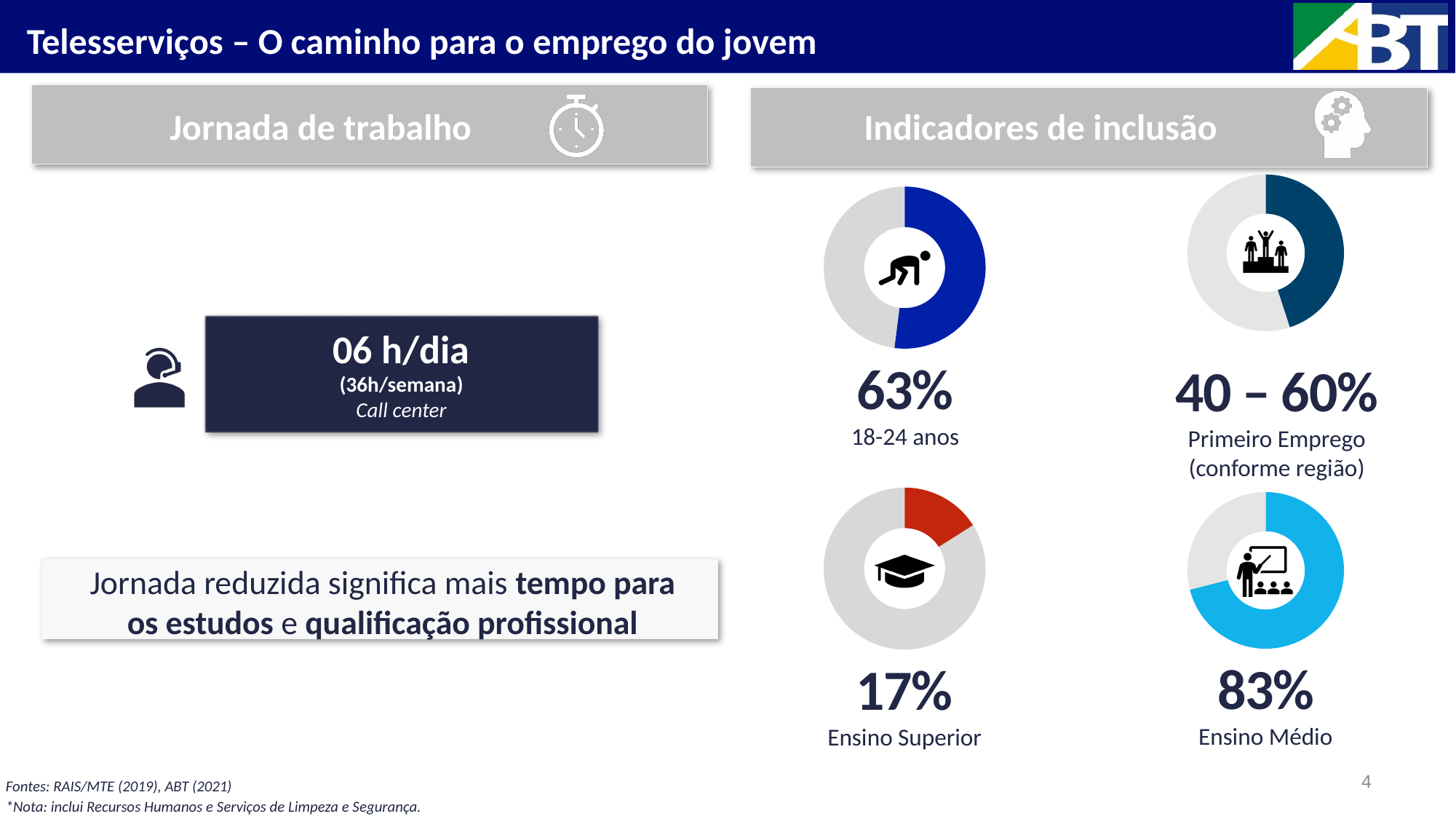
In the "Ensino Superior" donut chart, what percentage is shown? 17% What range is shown for the "Primeiro Emprego (conforme região)" donut chart? 40 – 60% What is the difference between the "Ensino Médio" percentage and the "Ensino Superior" percentage? 66 percentage points What is the difference between the "18-24 anos" percentage and the "Ensino Superior" percentage? 46 percentage points In the "18-24 anos" donut chart, what percentage is shown? 63% What colour is the filled segment of the "Ensino Superior" donut chart? Red Which of the four inclusion indicator donut charts shows the highest percentage? Ensino Médio Which is larger, the percentage for "Ensino Médio" or for "Ensino Superior"? Ensino Médio In the "Ensino Médio" donut chart, what percentage is shown? 83% Which of the four inclusion indicator donut charts shows the lowest percentage? Ensino Superior How many donut charts are shown under "Indicadores de inclusão"? 4 What kind of charts are shown under "Indicadores de inclusão"? Donut (pie) charts